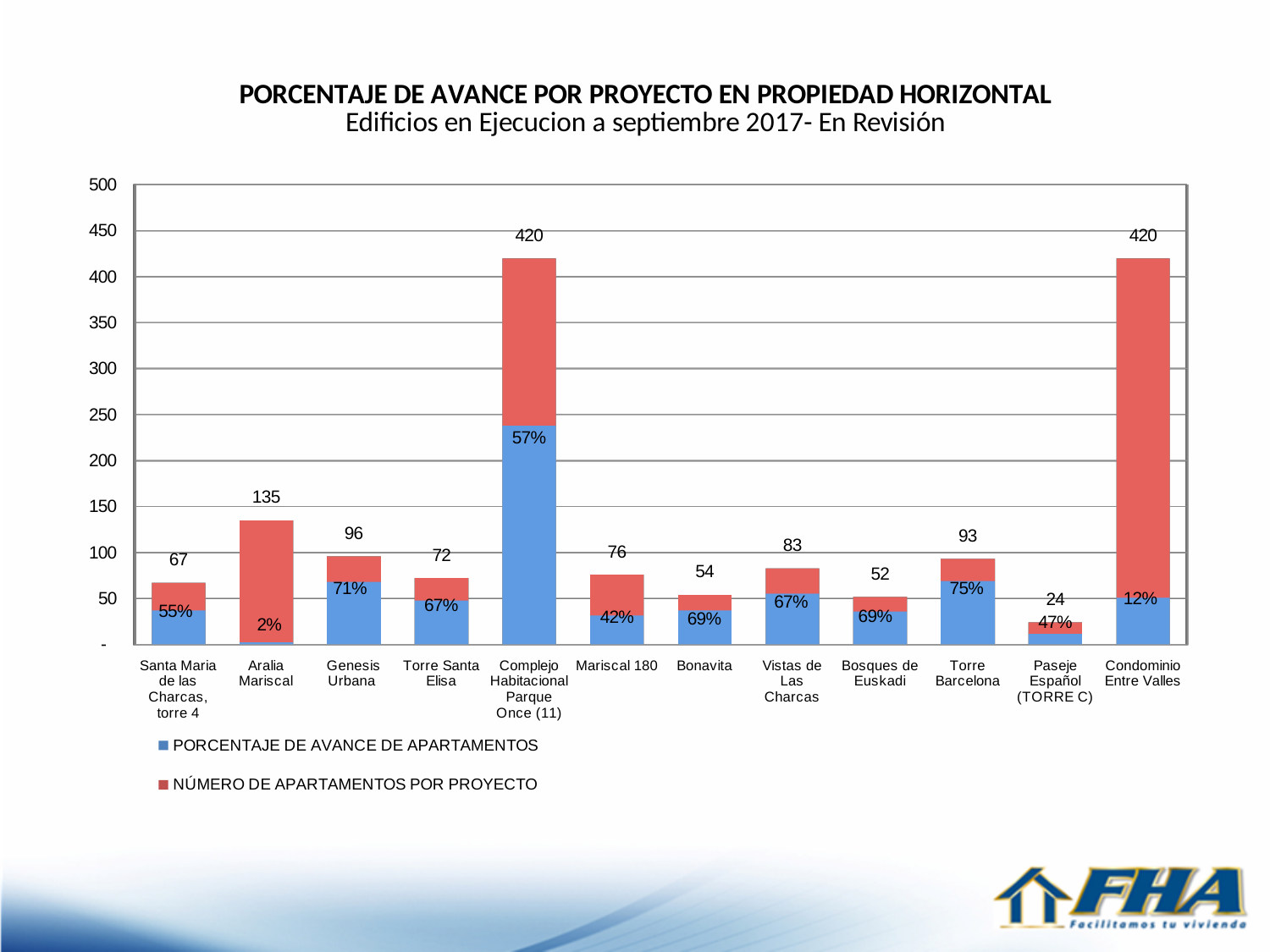
Which has more apartments, Vistas de Las Charcas or Bosques de Euskadi? Vistas de Las Charcas Which legend entry is shown in red? NÚMERO DE APARTAMENTOS POR PROYECTO What is the number of apartments for Aralia Mariscal? 135 What is the number of apartments for Complejo Habitacional Parque Once (11)? 420 What is the percentage of progress for Condominio Entre Valles? 12% What is the percentage of progress (porcentaje de avance) for Torre Barcelona? 75% Which project has the lowest number of apartments? Paseje Español (TORRE C) How many projects are shown on the x axis? 12 What kind of chart is shown on the slide? Stacked bar chart What is the difference in number of apartments between Genesis Urbana and Torre Santa Elisa? 24 Which project has the lowest percentage of progress? Aralia Mariscal How many series does the legend list? 2